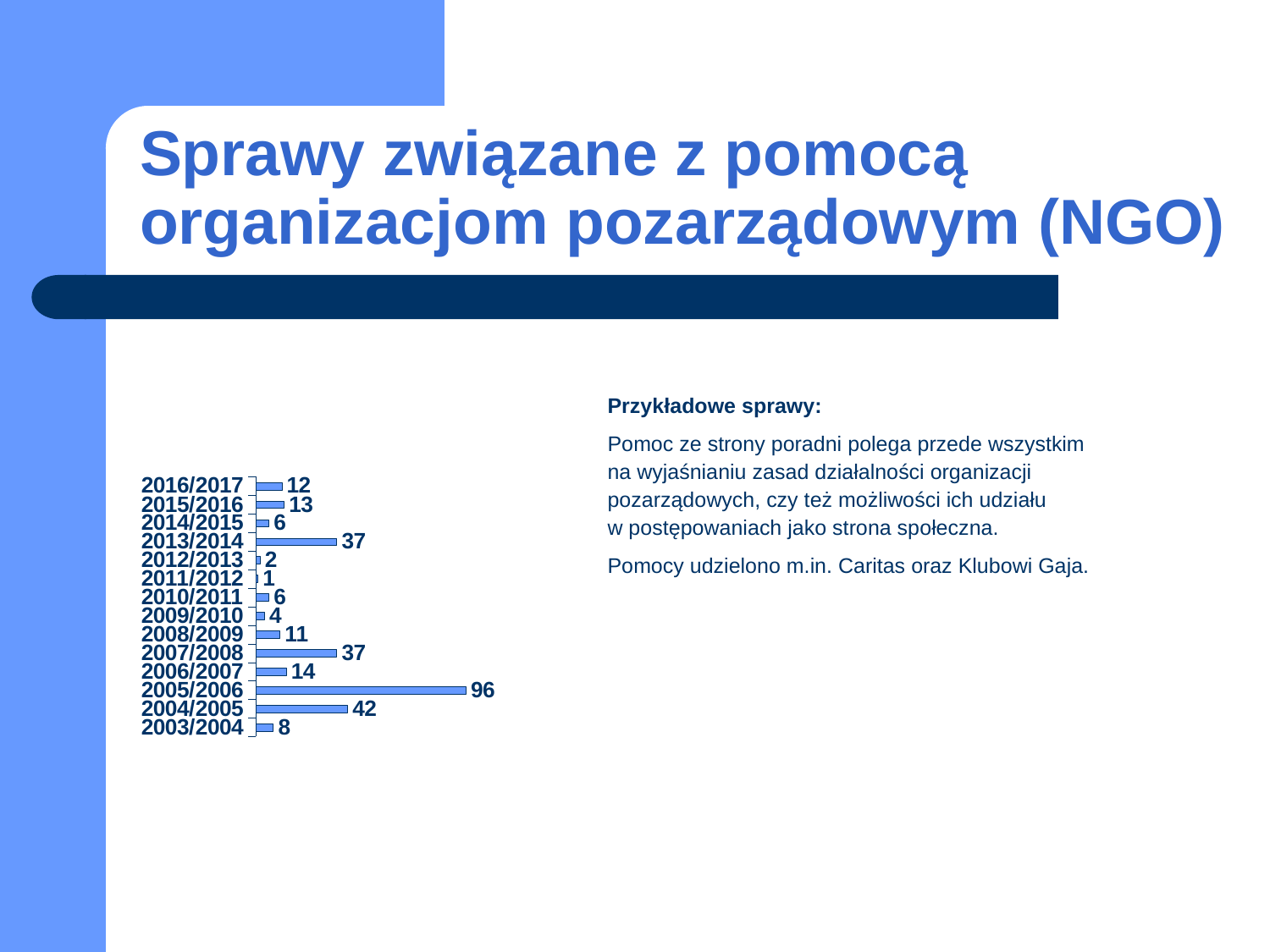
What is the value for 2004/2005? 42 How many periods are shown in the chart? 14 Which period has the lowest value? 2011/2012 What is the difference between the values for 2005/2006 and 2004/2005? 54 Which is larger, the value for 2003/2004 or the value for 2009/2010? 2003/2004 What kind of chart is shown on the slide? bar chart What is the value for 2011/2012? 1 What is the value for 2005/2006? 96 Which period has the highest value? 2005/2006 What is the value for 2013/2014? 37 What is the difference between the values for 2006/2007 and 2016/2017? 2 Which is larger, the value for 2015/2016 or the value for 2008/2009? 2015/2016